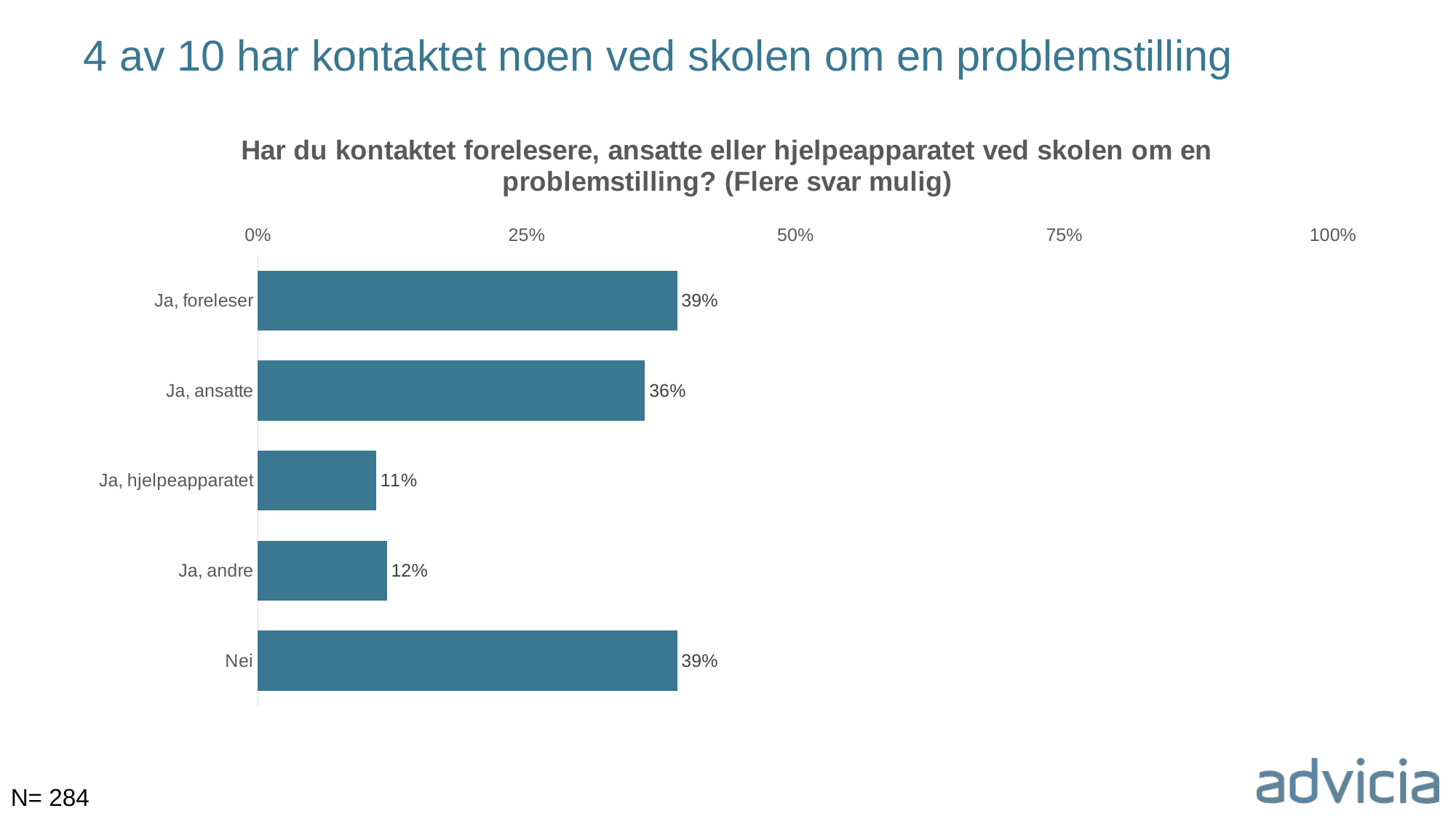
Which category has the lowest value? Ja, hjelpeapparatet What kind of chart is shown on the slide? bar chart What is the difference between the values for "Ja, andre" and "Ja, hjelpeapparatet"? 1% What is the value for "Ja, hjelpeapparatet"? 11% Which is larger, the value for "Ja, ansatte" or the value for "Ja, andre"? Ja, ansatte How many categories are shown in the chart? 5 What is the value for "Ja, ansatte"? 36% What is the difference between the values for "Ja, foreleser" and "Ja, ansatte"? 3% What is the value for "Nei"? 39% Is the value for "Nei" greater or less than 50%? less What is the value for "Ja, foreleser"? 39% What is the value for "Ja, andre"? 12%